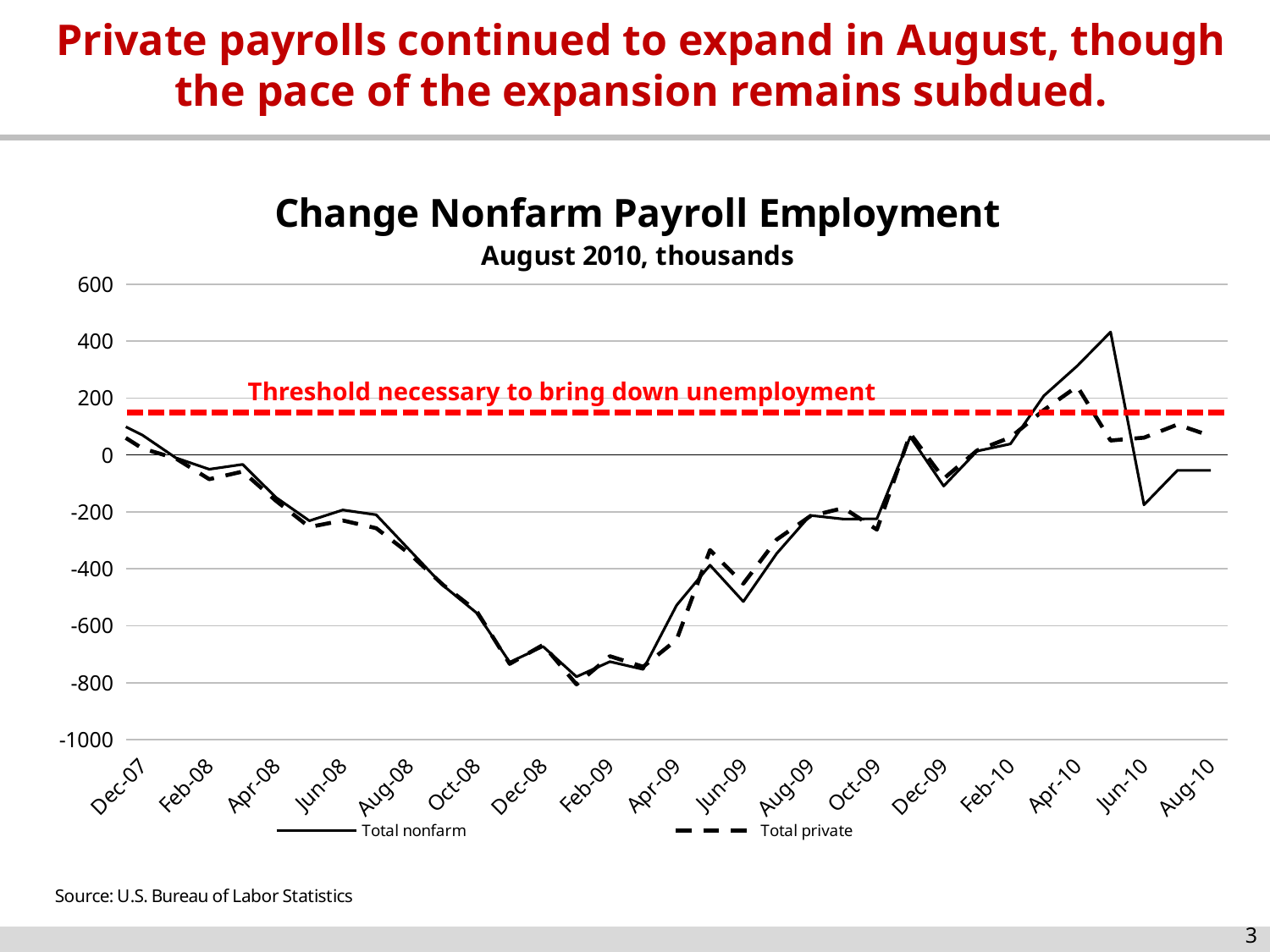
Is the value for Total private at Aug-10 greater or less than 0? greater Is the value for Total nonfarm at Jun-10 greater or less than -100? less What are the two series named in the legend? Total nonfarm and Total private At Jun-10, which series has the higher value, Total nonfarm or Total private? Total private How many series does the legend list? 2 Does the Total nonfarm line rise or fall from Dec-07 to Dec-08? Fall What does the red dashed horizontal line represent, according to its label? Threshold necessary to bring down unemployment How many month labels are shown along the x axis? 17 Is the value for Total nonfarm at Dec-07 greater or less than 0? greater What kind of chart is shown on the slide? Line chart